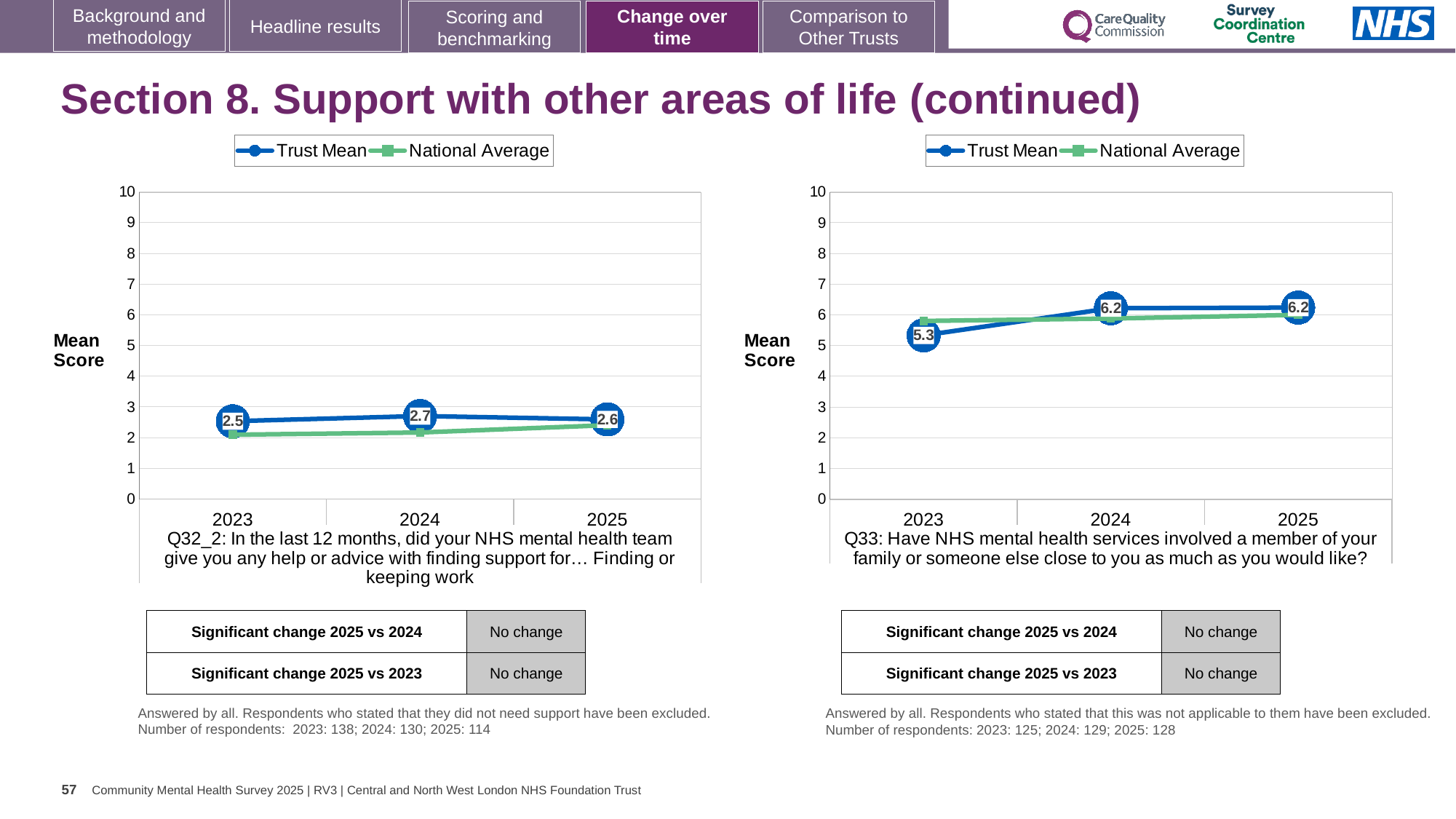
In the left chart (Q32_2), is the Trust Mean higher in 2024 or in 2025? 2024 In the right chart (Q33), which year has the lowest Trust Mean? 2023 How many series does the legend of the left chart (Q32_2) list? 2 How many years are plotted on the x axis of the right chart (Q33)? 3 In the left chart (Q32_2), what is the Trust Mean for 2024? 2.7 In the right chart (Q33), is the National Average for 2023 greater or less than 5? greater In the right chart (Q33), what is the Trust Mean for 2023? 5.3 In the left chart (Q32_2), what is the Trust Mean for 2025? 2.6 In the left chart (Q32_2), is the National Average for 2023 greater or less than 3? less What kind of chart is the right chart (Q33)? Line chart In the left chart (Q32_2), which year has the highest Trust Mean? 2024 In the right chart (Q33), what is the difference between the Trust Mean for 2024 and for 2023? 0.9